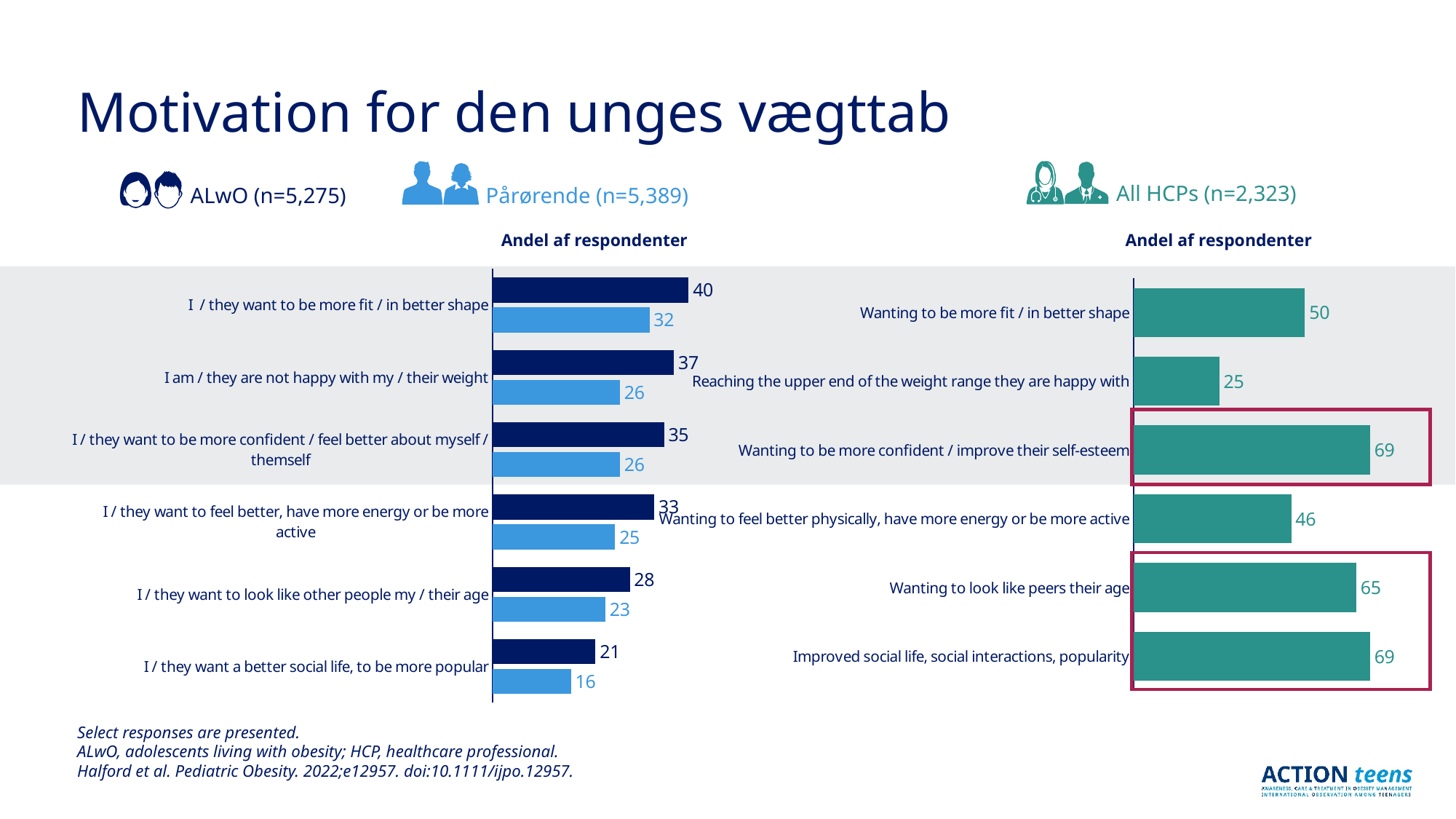
In the left chart (ALwO and Pårørende), which category has the highest ALwO value? I / they want to be more fit / in better shape In the right chart (All HCPs), what is the difference between "Wanting to be more confident / improve their self-esteem" and "Wanting to be more fit / in better shape"? 19 In the left chart (ALwO and Pårørende), what is the Pårørende value for "I / they want a better social life, to be more popular"? 16 How many categories are shown in the right chart (All HCPs)? 6 In the left chart (ALwO and Pårørende), what is the ALwO value for "I / they want to be more fit / in better shape"? 40 What type of chart is used on this slide? Bar chart In the right chart (All HCPs), which is larger: "Wanting to feel better physically, have more energy or be more active" or "Wanting to look like peers their age"? Wanting to look like peers their age In the right chart (All HCPs), what is the value for "Wanting to look like peers their age"? 65 How many respondent groups are plotted in the left chart? 2 In the right chart (All HCPs), which category has the lowest value? Reaching the upper end of the weight range they are happy with In the left chart (ALwO and Pårørende), which is larger for "I / they want to look like other people my / their age": the ALwO value or the Pårørende value? ALwO In the left chart (ALwO and Pårørende), what is the difference between the ALwO and Pårørende values for "I am / they are not happy with my / their weight"? 11